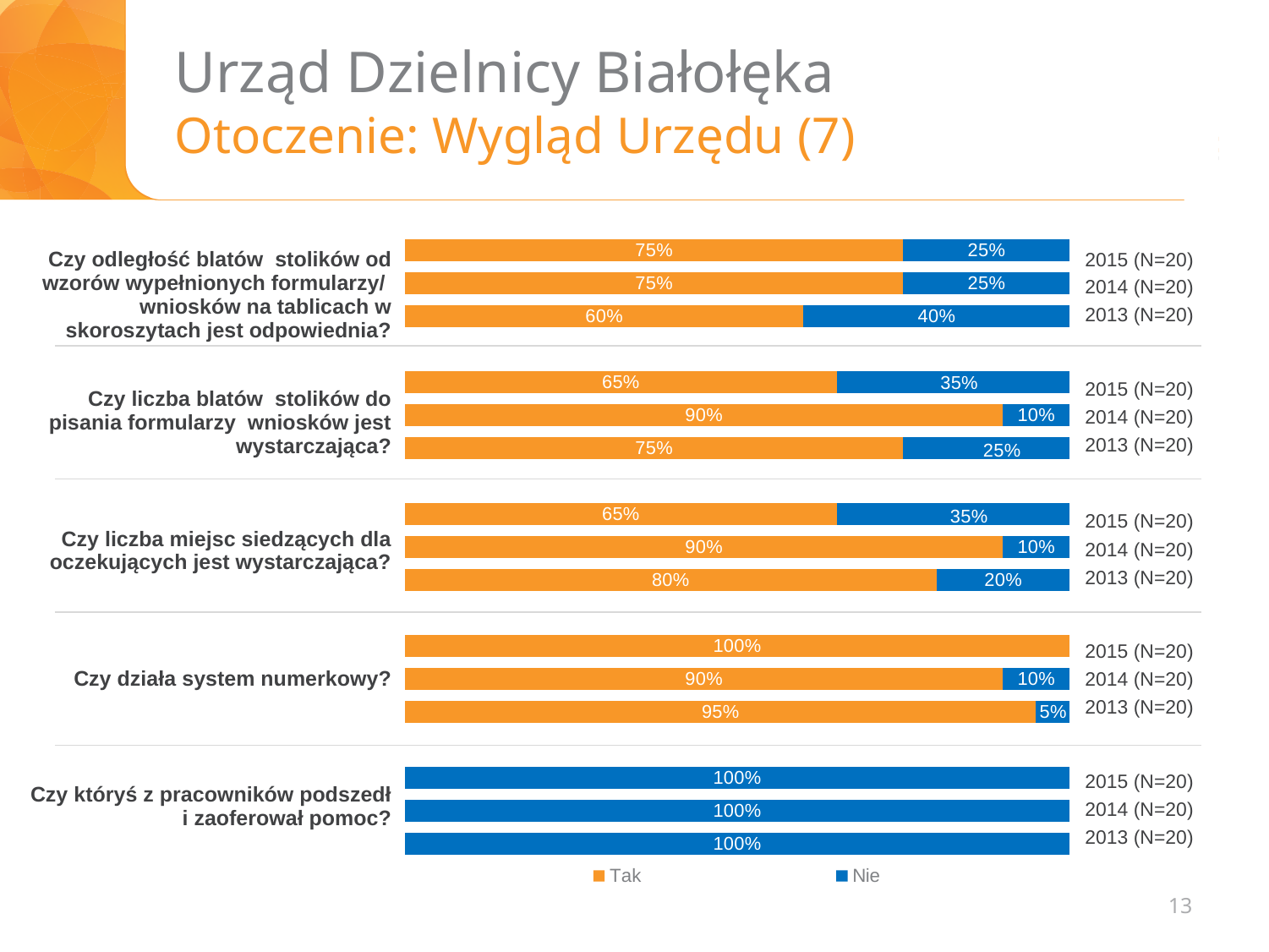
For 'Czy liczba blatów stolików do pisania formularzy wniosków jest wystarczająca?', which year has the highest 'Tak' value? 2014 (N=20) Which is larger: the 'Nie' value for 'Czy działa system numerkowy?' in 2014 (N=20) or in 2013 (N=20)? 2014 (N=20) What kind of chart is shown on the slide? stacked bar chart How many series does the legend list? 2 For 'Czy odległość blatów stolików od wzorów wypełnionych formularzy/wniosków na tablicach w skoroszytach jest odpowiednia?', which year has the lowest 'Tak' value? 2013 (N=20) What is the 'Nie' value for 'Czy działa system numerkowy?' in 2013 (N=20)? 5% What is the 'Nie' value for 'Czy któryś z pracowników podszedł i zaoferował pomoc?' in 2015 (N=20)? 100% What is the 'Tak' value for 'Czy liczba miejsc siedzących dla oczekujących jest wystarczająca?' in 2013 (N=20)? 80% What is the 'Tak' value for 'Czy działa system numerkowy?' in 2015 (N=20)? 100% What is the 'Nie' value for 'Czy liczba blatów stolików do pisania formularzy wniosków jest wystarczająca?' in 2014 (N=20)? 10% What are the two series named in the legend? Tak and Nie What is the difference between the 'Tak' values for 'Czy liczba miejsc siedzących dla oczekujących jest wystarczająca?' in 2014 (N=20) and 2015 (N=20)? 25%